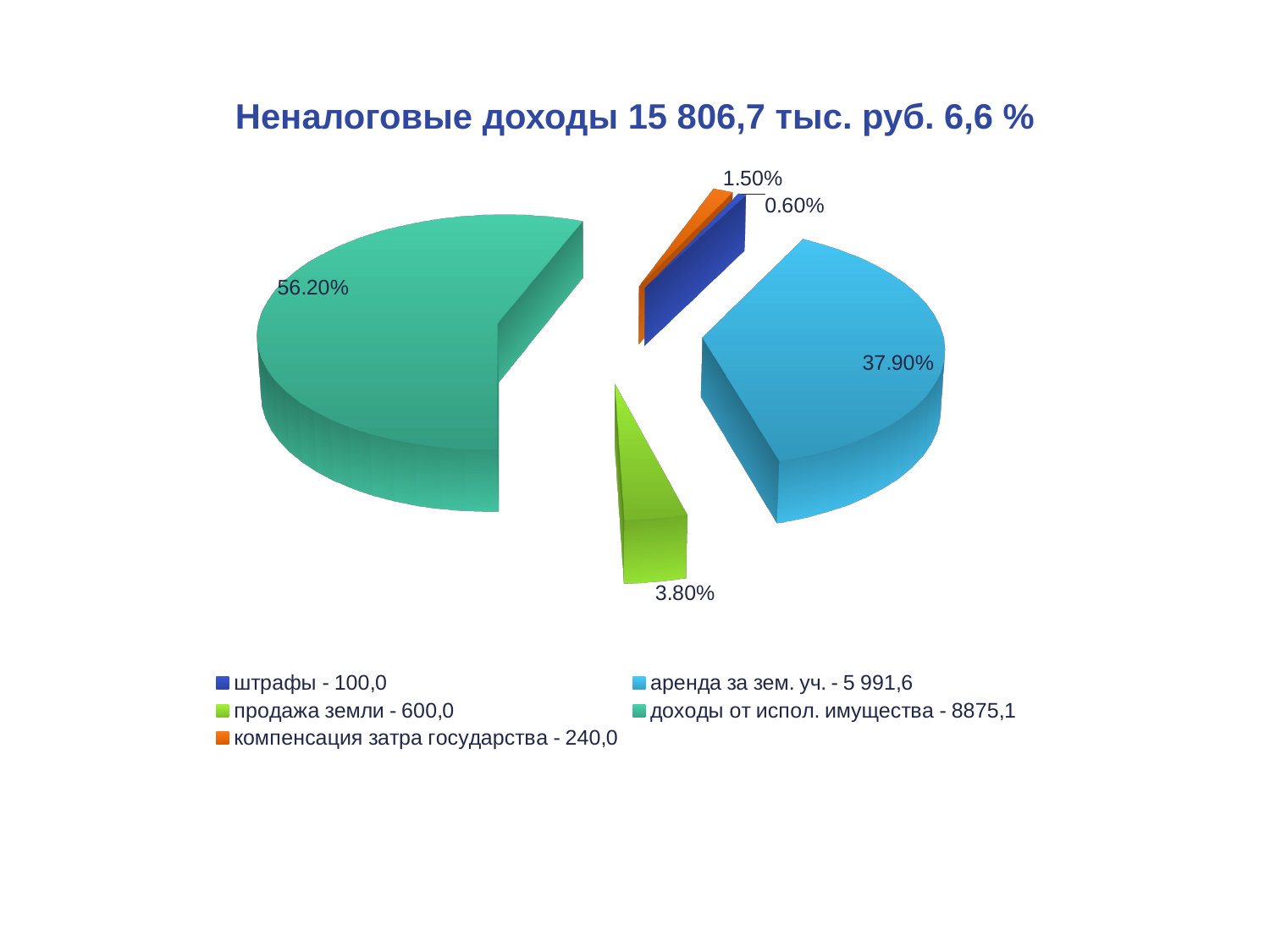
What is the difference in percentage points between the shares of "доходы от испол. имущества - 8875,1" and "аренда за зем. уч. - 5 991,6"? 18.30% What share of the pie does "продажа земли - 600,0" represent? 3.80% Which slice is larger: "продажа земли - 600,0" or "компенсация затра государства - 240,0"? продажа земли - 600,0 Which category has the largest slice of the pie? доходы от испол. имущества - 8875,1 How many slices does the pie chart have? 5 What share of the pie does "штрафы - 100,0" represent? 0.60% What is the title of the chart? Неналоговые доходы 15 806,7 тыс. руб. 6,6 % Which category has the smallest slice of the pie? штрафы - 100,0 What share of the pie does "компенсация затра государства - 240,0" represent? 1.50% What kind of chart is shown on the slide? pie chart